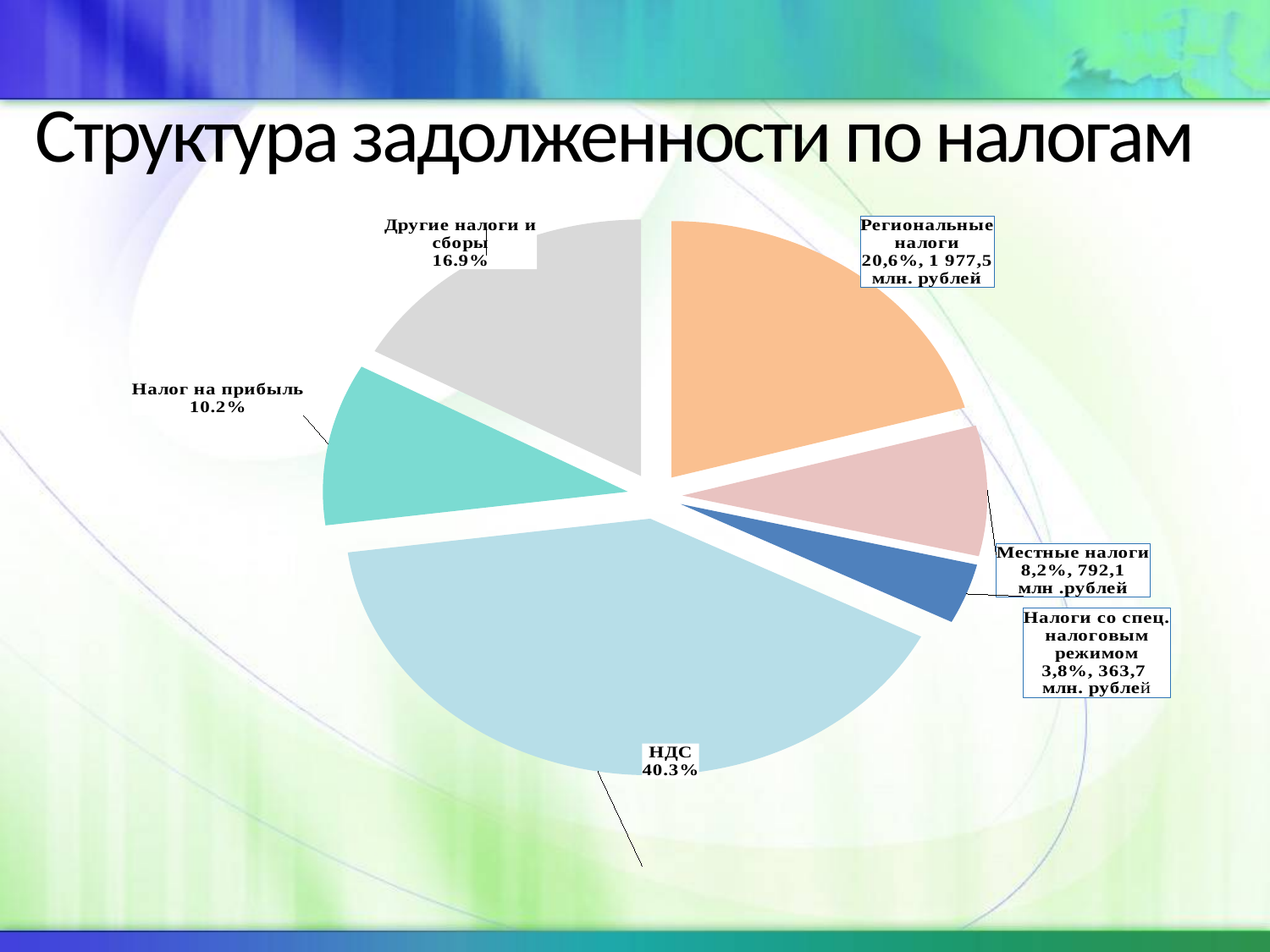
What is the title of the chart on the slide? Структура задолженности по налогам What share of the pie does НДС account for? 40.3% Which is larger: the share for Другие налоги и сборы or the share for Налог на прибыль? Другие налоги и сборы What amount in million rubles is shown for Местные налоги? 792,1 млн. рублей Which category has the largest share of the pie? НДС Which category has the smallest share of the pie? Налоги со спец. налоговым режимом What amount in million rubles is shown for Налоги со спец. налоговым режимом? 363,7 млн. рублей What percentage is shown for Региональные налоги? 20,6% What kind of chart is shown on the slide? pie chart What is the difference in percentage points between the share for НДС and the share for Региональные налоги? 19.7 How many slices does the pie chart have? 6 What is the percentage shown for Налог на прибыль? 10.2%